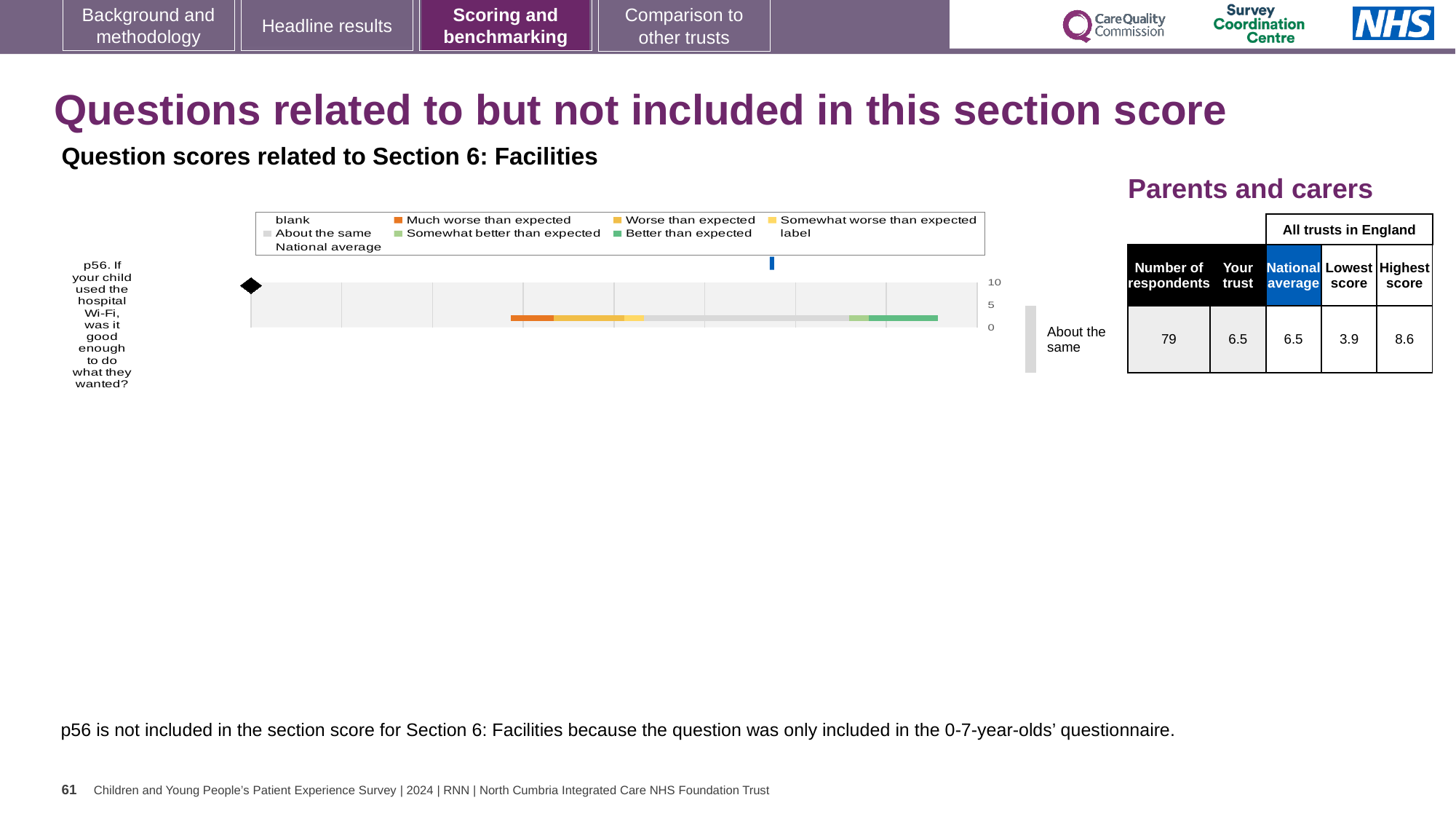
In the table beside the chart, how many respondents answered p56? 79 In the table beside the chart, what is the lowest score among all trusts in England for p56? 3.9 In the table beside the chart, what is the national average score for p56? 6.5 Which question is plotted in the chart? p56. If your child used the hospital Wi-Fi, was it good enough to do what they wanted? In the table beside the chart, what is the 'Your trust' score for p56? 6.5 How many entries does the chart legend list? 9 What is the difference between the highest score and the lowest score for p56 in the table beside the chart? 4.7 In the table beside the chart, what is the highest score among all trusts in England for p56? 8.6 Which is larger for p56: the 'Your trust' score or the lowest score among all trusts in England? Your trust What is the highest value shown on the chart's axis? 10 What kind of chart is used to show the p56 question score? bar chart How many questions are plotted in the chart? 1